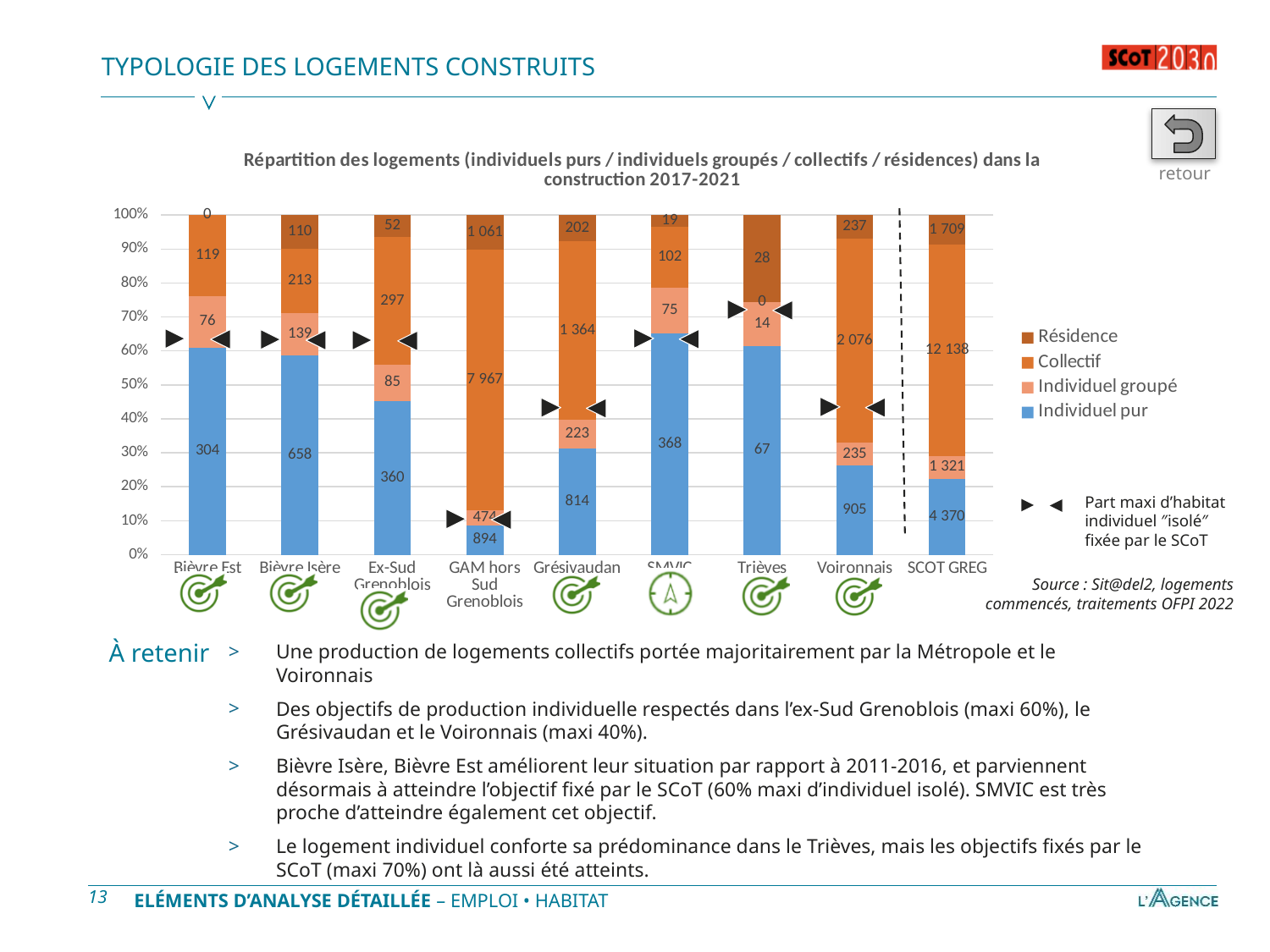
What is the value of Individuel groupé for Grésivaudan? 223 Which series is shown in the darkest (brown-orange) colour at the top of each bar? Résidence Which is larger, the Collectif value for Bièvre Isère or for Ex-Sud Grenoblois? Ex-Sud Grenoblois What is the difference between the Individuel pur values for Voironnais and Grésivaudan? 91 What type of chart is shown on the slide? Stacked bar chart What is the value of Individuel pur for Bièvre Isère? 658 What is the total of all four segments for the Trièves bar? 109 What is the value of Résidence for Voironnais? 237 How many territories (categories) are shown along the x axis? 9 What is the value of Collectif for SCOT GREG? 12 138 How many series does the legend list? 4 What is the value of Collectif for GAM hors Sud Grenoblois? 7 967